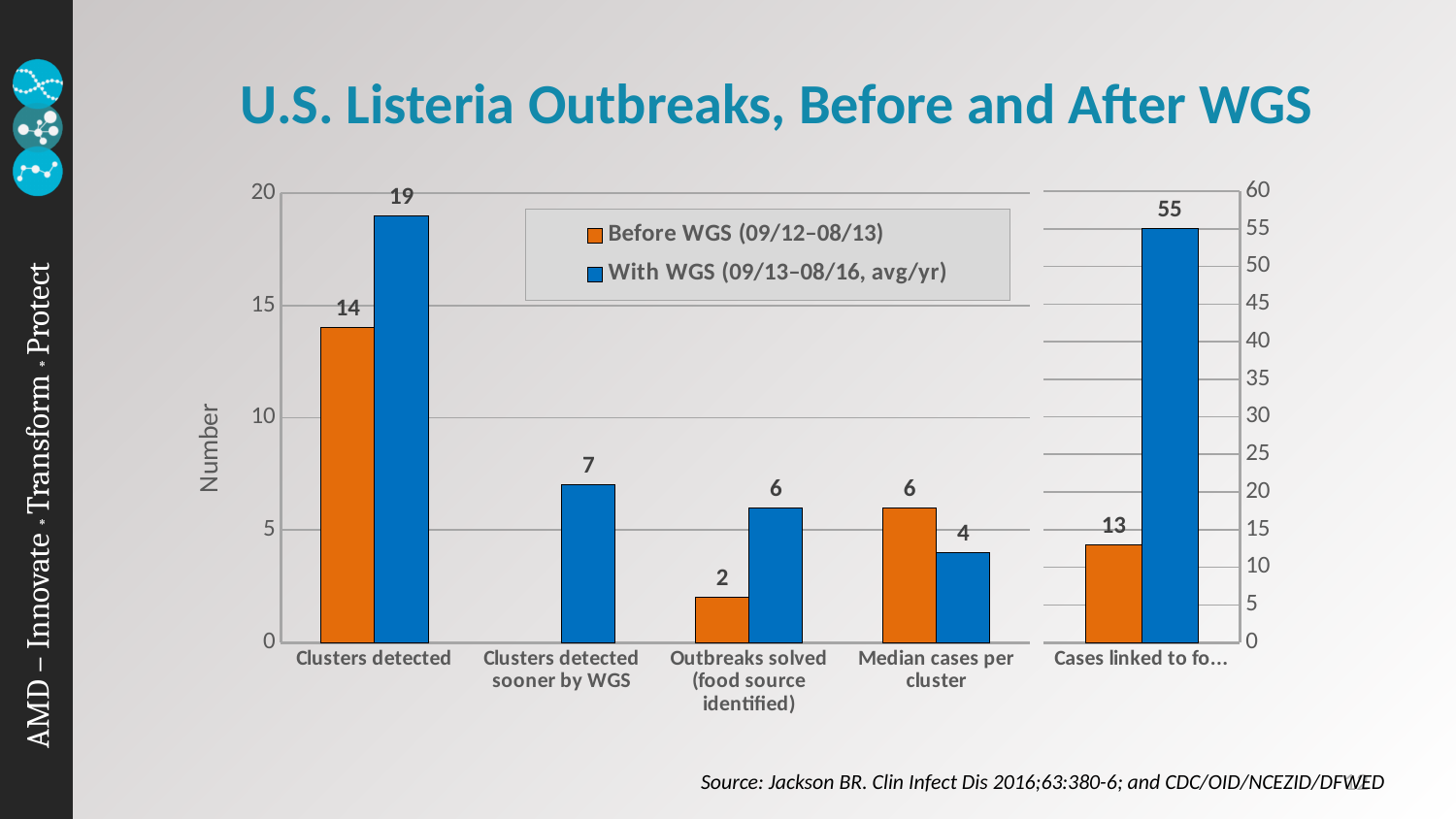
What is the With WGS value for Median cases per cluster? 4 What is the Before WGS value for Outbreaks solved (food source identified)? 2 Which category has the highest With WGS value? Cases linked to fo… What is the difference between the Before WGS and With WGS values for Outbreaks solved (food source identified)? 4 Which is larger for Median cases per cluster, the Before WGS value or the With WGS value? Before WGS What is the With WGS value for Clusters detected sooner by WGS? 7 What is the value for Before WGS in the Clusters detected category? 14 What kind of chart is shown on the slide? Bar chart What is the value for With WGS in the Clusters detected category? 19 What colour represents the Before WGS series? Orange What is the difference between the With WGS and Before WGS values for Clusters detected? 5 How many series does the legend list? 2